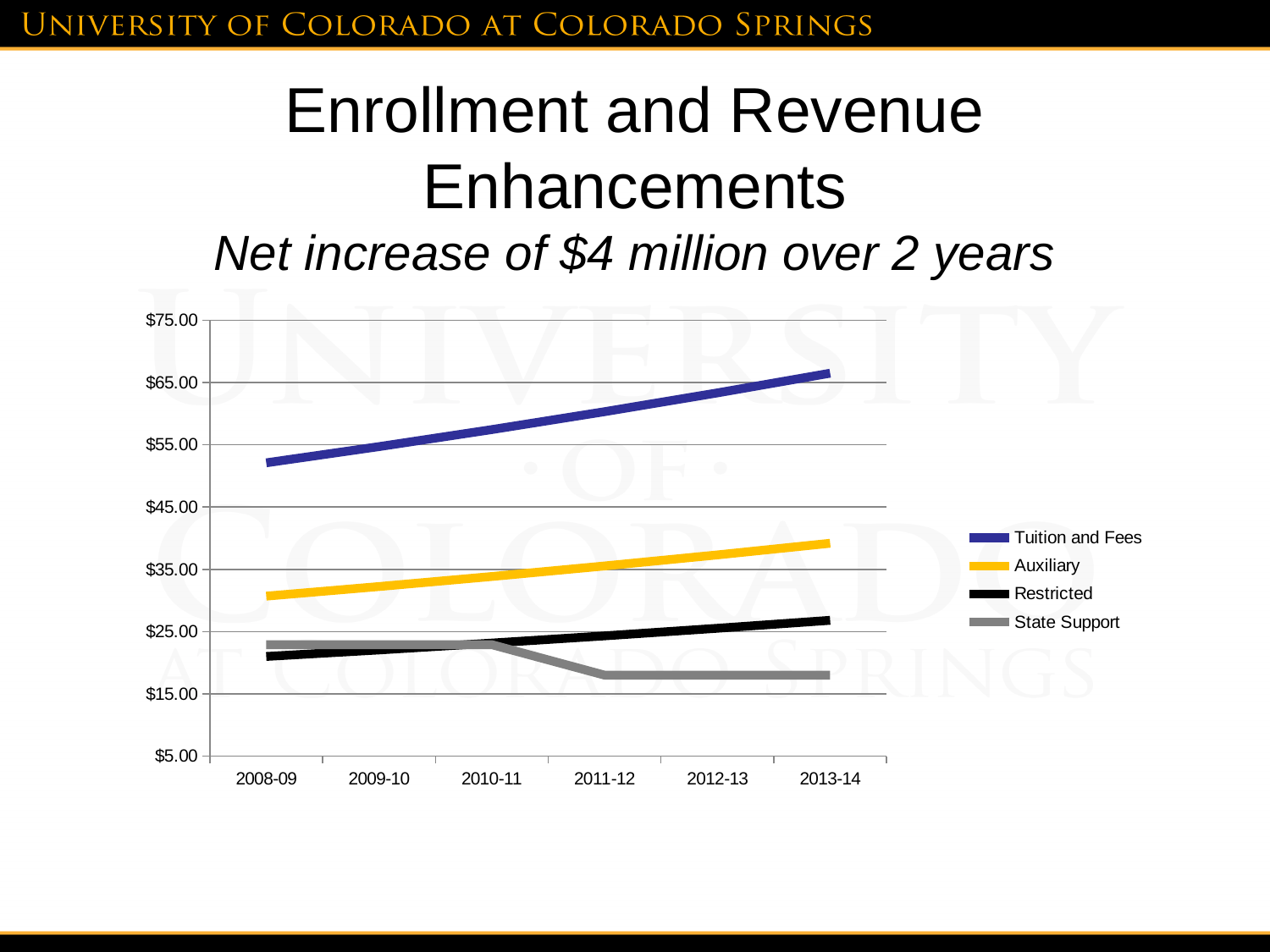
Which series has the highest value in 2013-14? Tuition and Fees How many series does the legend list? 4 What kind of chart is shown on the slide? line chart In 2013-14, which is larger: Restricted or State Support? Restricted Is the value for Auxiliary in 2013-14 greater or less than $35.00? greater How many academic years are shown along the x axis? 6 Which series is drawn in yellow in the legend? Auxiliary Which series has the lowest value in 2013-14? State Support Is the value for State Support in 2013-14 greater or less than $25.00? less Does the Tuition and Fees line rise or fall from 2008-09 to 2013-14? rise Does the State Support line rise or fall overall from 2008-09 to 2013-14? fall Is the value for Tuition and Fees in 2008-09 greater or less than $55.00? less